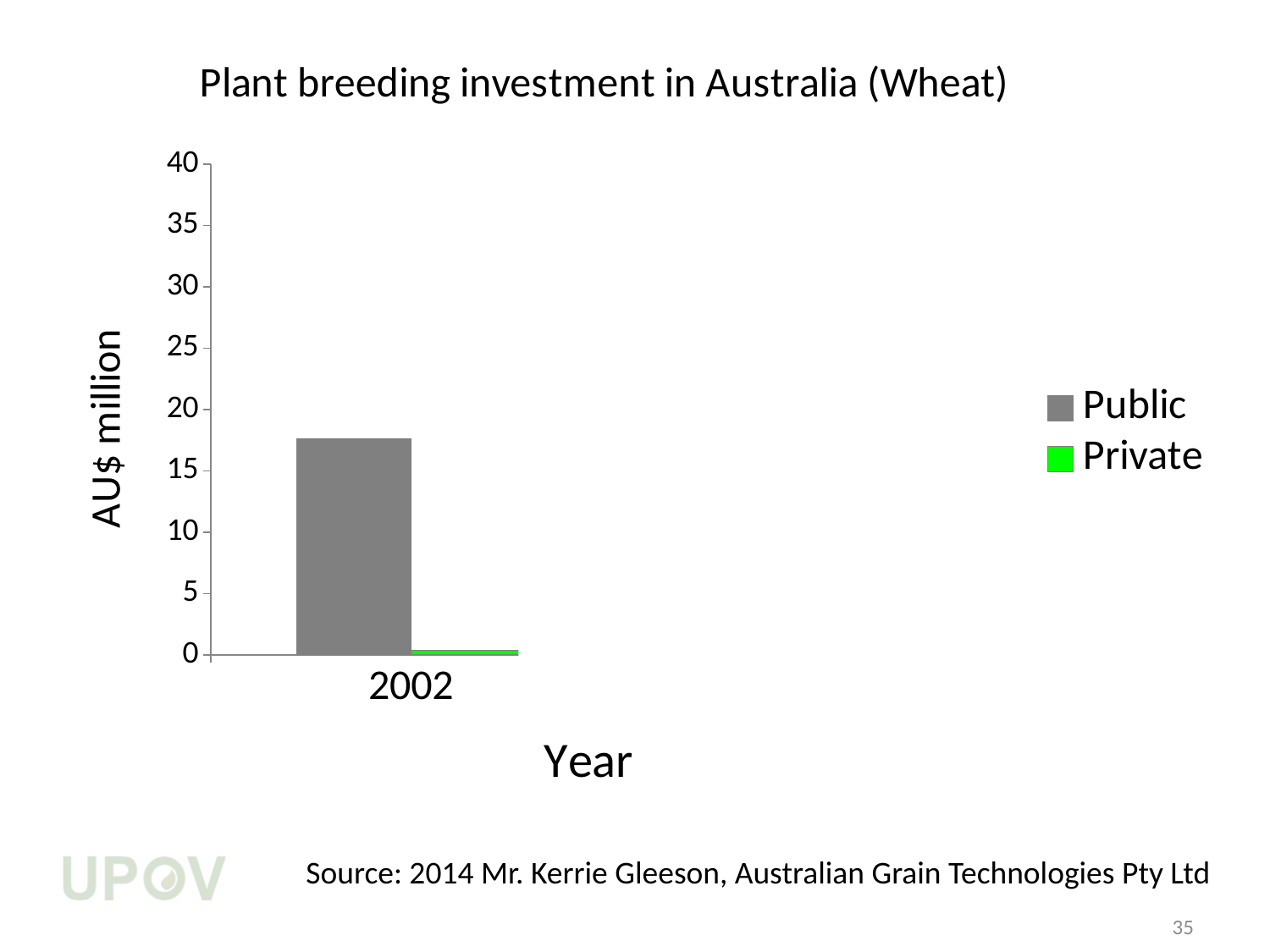
How many series does the legend list? 2 Is the Private value for 2002 greater or less than 5? less Which series has the lowest value in 2002? Private Which year is shown on the x axis? 2002 Is the Public value for 2002 greater or less than 20? less Is the Public value for 2002 greater or less than 15? greater What is the label of the y axis? AU$ million What kind of chart is shown on the slide? bar chart How many years are shown on the x axis? 1 Which series has the larger value in 2002, Public or Private? Public What is the title of the chart? Plant breeding investment in Australia (Wheat)